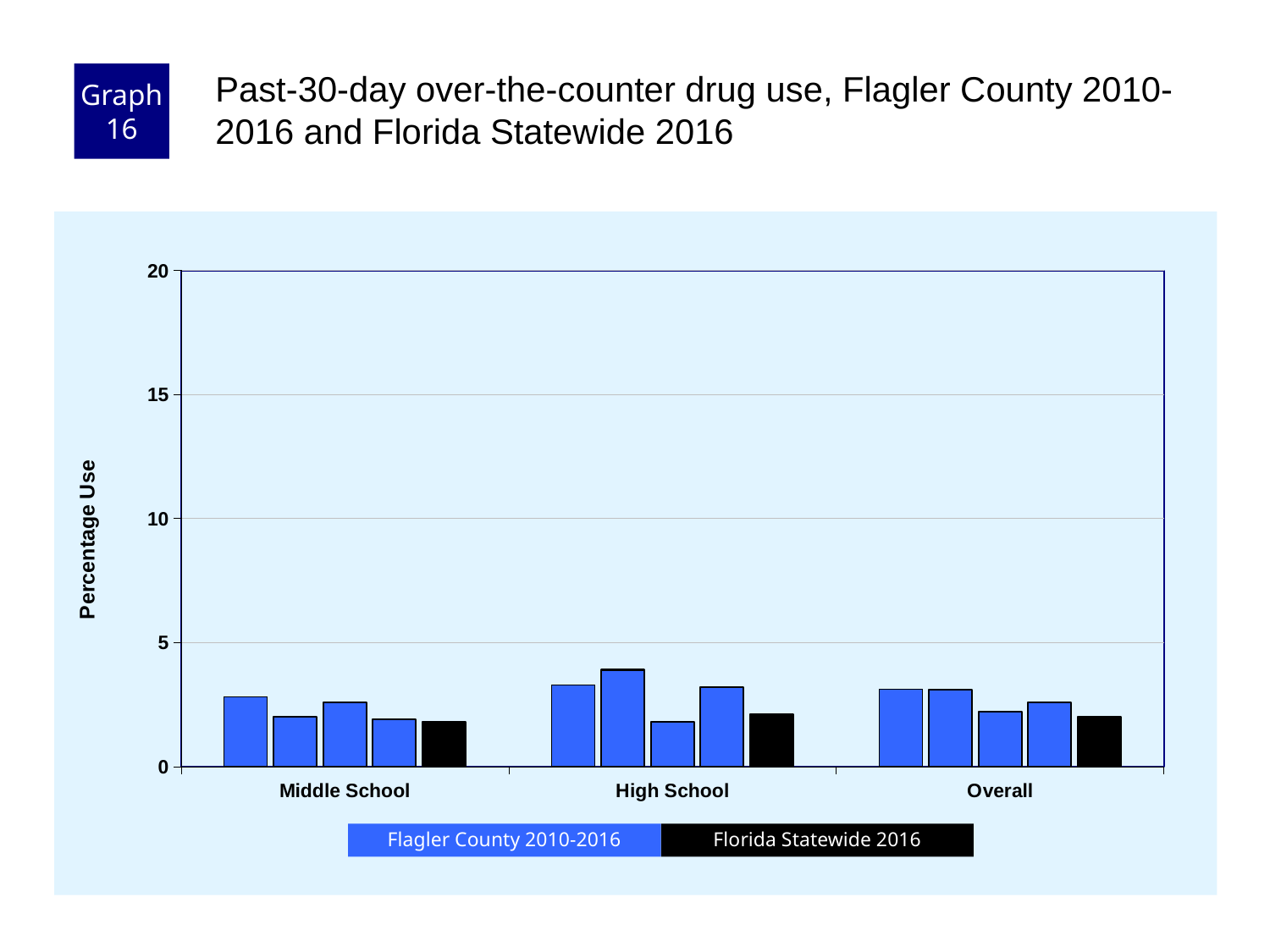
How many categories are shown on the x axis? 3 How many bars are plotted in each category group? 5 Is the Florida Statewide 2016 value for High School greater or less than 5? less Is the Florida Statewide 2016 value for Middle School greater or less than 5? less How many series does the legend list? 2 What is the highest value shown on the y axis? 20 Which category contains the tallest bar on the chart? High School What colour represents Florida Statewide 2016 in the legend? black In the High School group, is the tallest Flagler County 2010-2016 bar larger or smaller than the Florida Statewide 2016 bar? larger What kind of chart is shown on the slide? bar chart What is the label of the y axis? Percentage Use Are any of the plotted values greater than 10? No